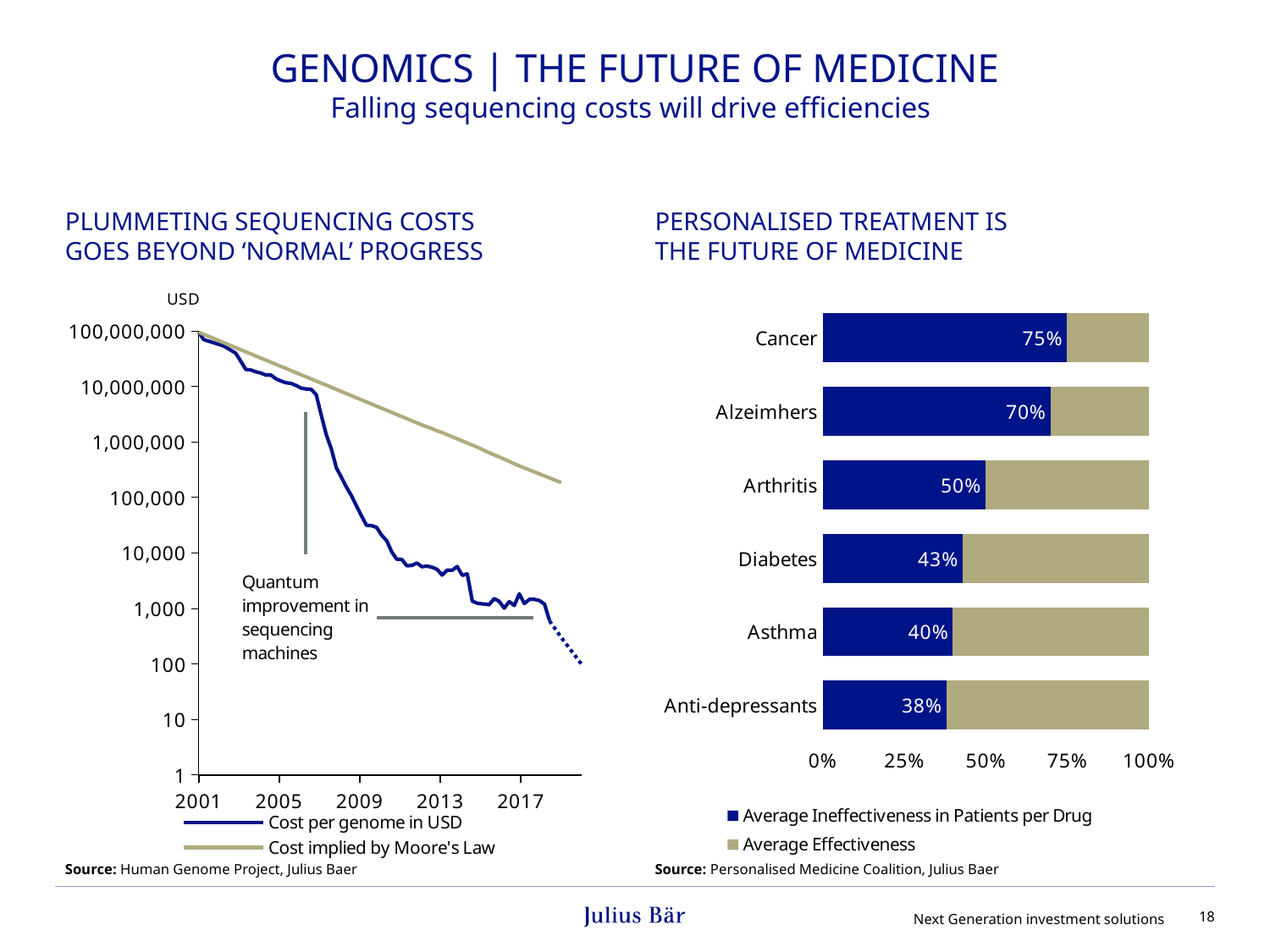
In the 'Personalised treatment is the future of medicine' chart, which condition has the lowest average ineffectiveness in patients per drug? Anti-depressants How many conditions are shown in the 'Personalised treatment is the future of medicine' chart? 6 What kind of chart is the 'Plummeting sequencing costs goes beyond normal progress' chart? Line chart In the 'Plummeting sequencing costs' chart, does the cost per genome in USD rise or fall from 2001 to 2017? Fall In the 'Personalised treatment is the future of medicine' chart, what is the average ineffectiveness in patients per drug for Cancer? 75% How many series does the legend of the 'Personalised treatment is the future of medicine' chart list? 2 In the 'Personalised treatment is the future of medicine' chart, what is the average ineffectiveness value shown for Diabetes? 43% In the 'Plummeting sequencing costs' chart, is the cost per genome in USD in 2013 greater or less than 100,000? less In the 'Personalised treatment is the future of medicine' chart, which has a higher average ineffectiveness, Asthma or Alzeimhers? Alzeimhers In the 'Personalised treatment is the future of medicine' chart, which condition has the highest average ineffectiveness in patients per drug? Cancer In the 'Personalised treatment is the future of medicine' chart, what is the difference in average ineffectiveness between Cancer and Arthritis? 25% In the 'Personalised treatment is the future of medicine' chart, what is the average ineffectiveness value shown for Anti-depressants? 38%